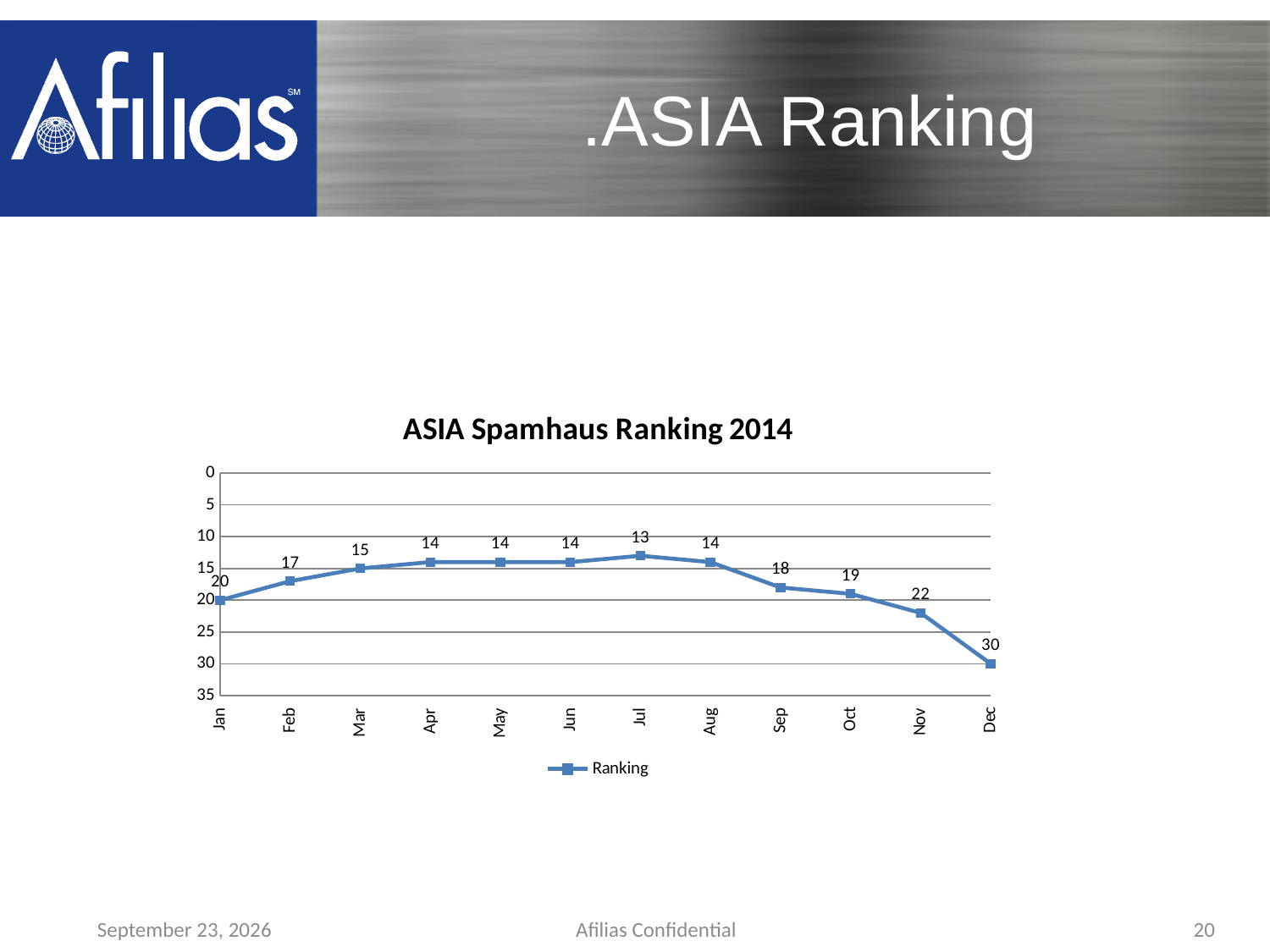
What is the Ranking value for Sep? 18 What is the Ranking value for Jan? 20 What is the difference between the Ranking values for Jan and Feb? 3 Which month has the lowest Ranking value? Jul What is the Ranking value for Dec? 30 What is the difference between the Ranking values for Dec and Nov? 8 How many series does the legend list? 1 How many months are plotted on the x axis? 12 Which is larger, the Ranking value for Oct or for Mar? Oct Which month has the highest Ranking value? Dec What kind of chart is shown on the slide? Line chart What is the Ranking value for Jul in the ASIA Spamhaus Ranking 2014 chart? 13